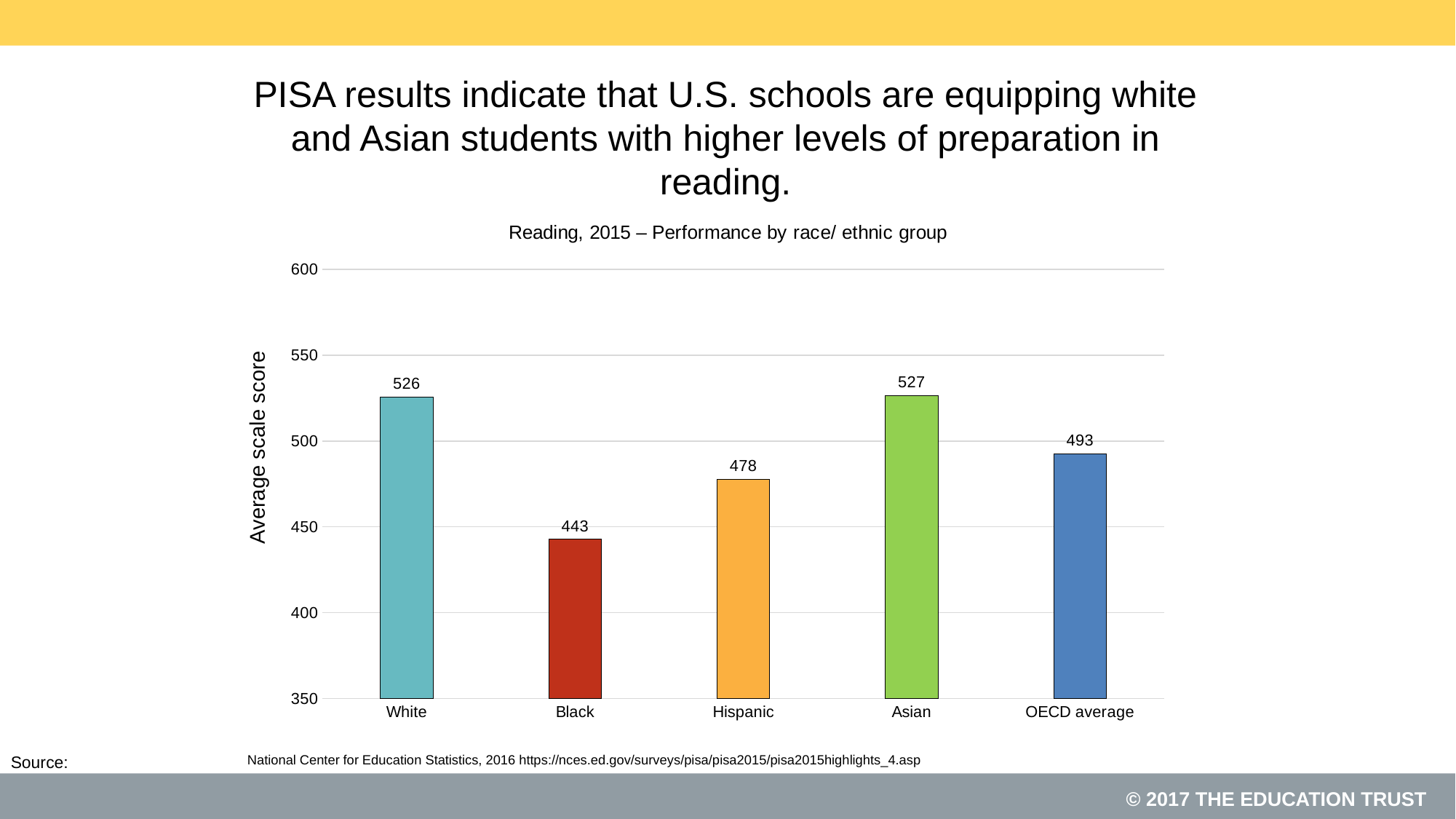
What is the difference between the Asian score and the Black score? 84 What is the average scale score for White students in the chart? 526 What kind of chart is shown on the slide? Bar chart What is the title of the chart? Reading, 2015 – Performance by race/ ethnic group Which group has the highest average scale score? Asian How many categories are shown on the x axis of the chart? 5 What is the average scale score for Black students? 443 What is the OECD average reading score shown in the chart? 493 What is the average scale score for Hispanic students? 478 What is the difference between the White score and the OECD average? 33 Which group has the lowest average scale score? Black Which is larger, the Hispanic score or the OECD average? OECD average